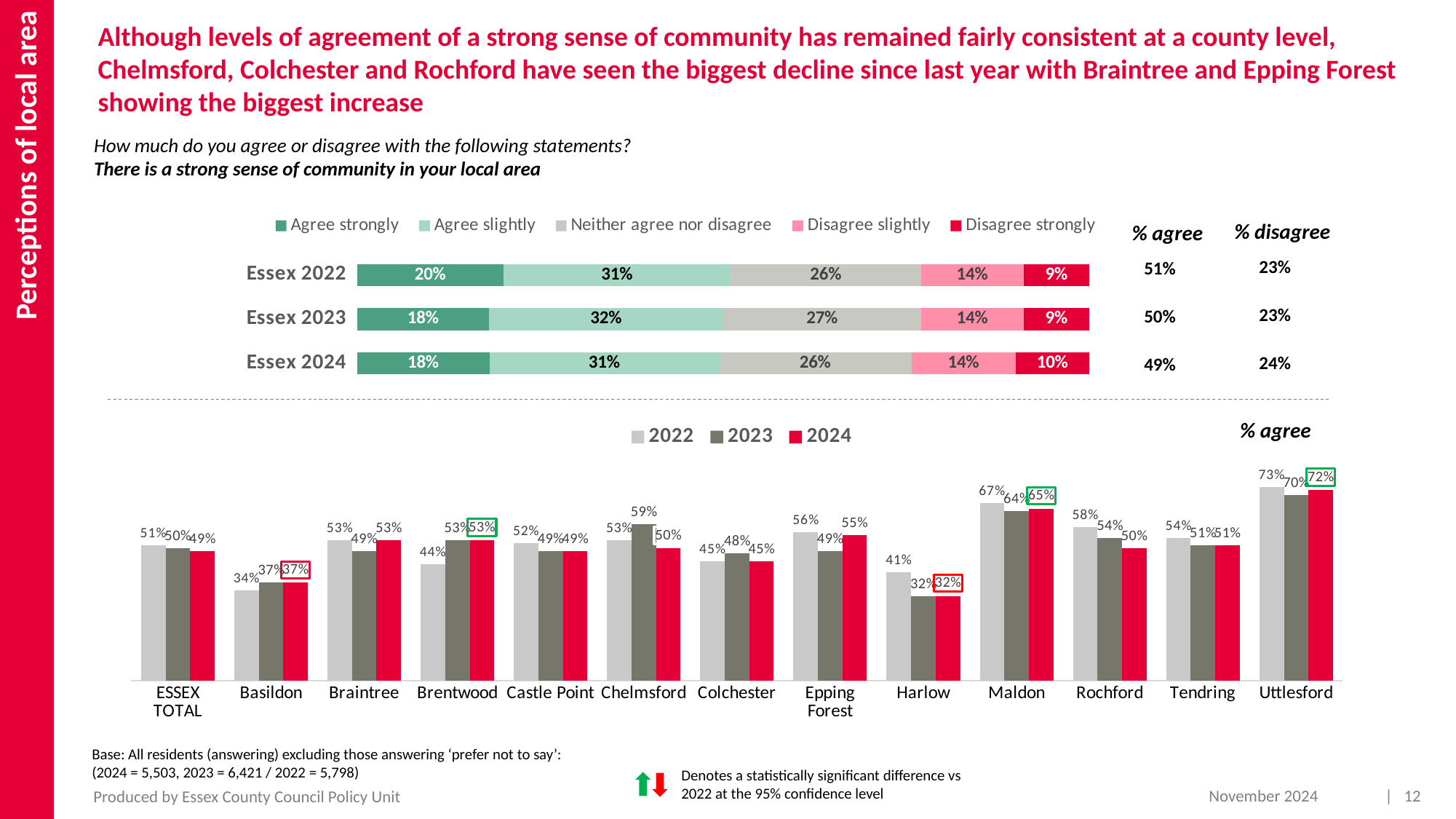
In the bottom bar chart, what is the difference between the 2022 and 2024 % agree values for Rochford? 8% In the top stacked bar chart, how many series does the legend list? 5 In the bottom bar chart, which is larger for Chelmsford: the 2023 value or the 2024 value? 2023 In the bottom bar chart, how many districts/categories are shown on the x axis? 13 In the bottom bar chart, which district has the highest 2024 % agree value? Uttlesford In the top stacked bar chart, what percentage of Essex 2024 respondents 'Disagree strongly'? 10% In the bottom bar chart, what is the 2024 % agree value for Maldon? 65% In the bottom bar chart, what is the 2022 % agree value for Harlow? 41% In the bottom bar chart, which district has the lowest 2024 % agree value? Harlow In the top stacked bar chart, what percentage of Essex 2022 respondents 'Agree strongly'? 20% What kind of chart is the bottom chart on the slide? Bar chart In the top stacked bar chart, what is the combined 'Agree strongly' and 'Agree slightly' share for Essex 2023? 50%